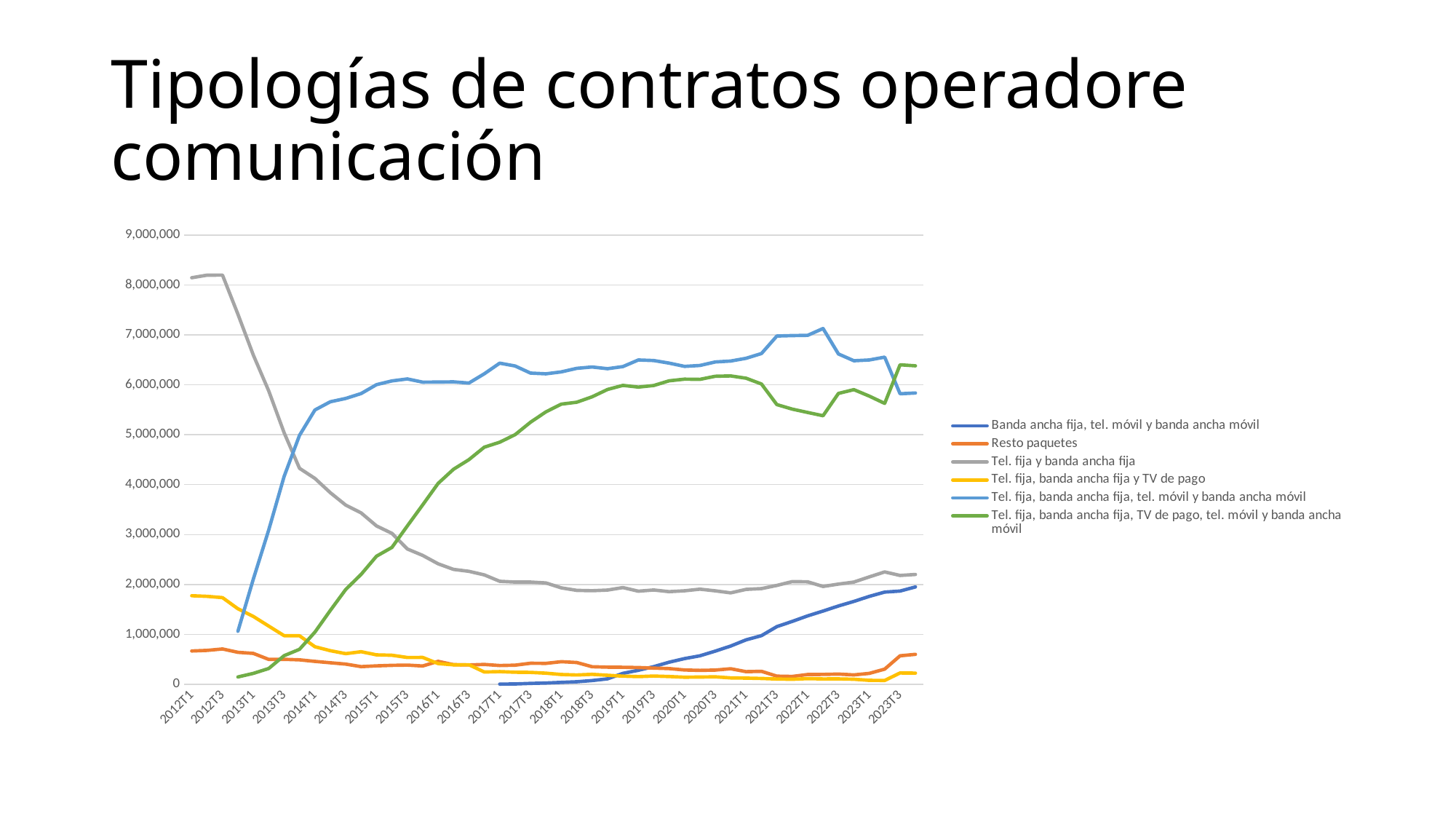
Which series has the highest value at 2012T1? Tel. fija y banda ancha fija Is the value for Tel. fija, banda ancha fija y TV de pago at 2012T1 greater or less than 2,000,000? less Is the value for Tel. fija, banda ancha fija, TV de pago, tel. móvil y banda ancha móvil at 2013T1 greater or less than 1,000,000? less How many series does the legend list? 6 Does the Banda ancha fija, tel. móvil y banda ancha móvil series rise or fall between 2017T1 and 2023T3? rise At 2015T1, which is larger: Tel. fija, banda ancha fija, tel. móvil y banda ancha móvil or Tel. fija y banda ancha fija? Tel. fija, banda ancha fija, tel. móvil y banda ancha móvil Is the value for Tel. fija y banda ancha fija at 2012T1 greater or less than 7,000,000? greater What kind of chart is shown on the slide? line chart What colour is the Resto paquetes line in the chart? orange Which series has the lowest value at 2023T3? Tel. fija, banda ancha fija y TV de pago Does the Tel. fija y banda ancha fija series rise or fall between 2012T3 and 2017T1? fall